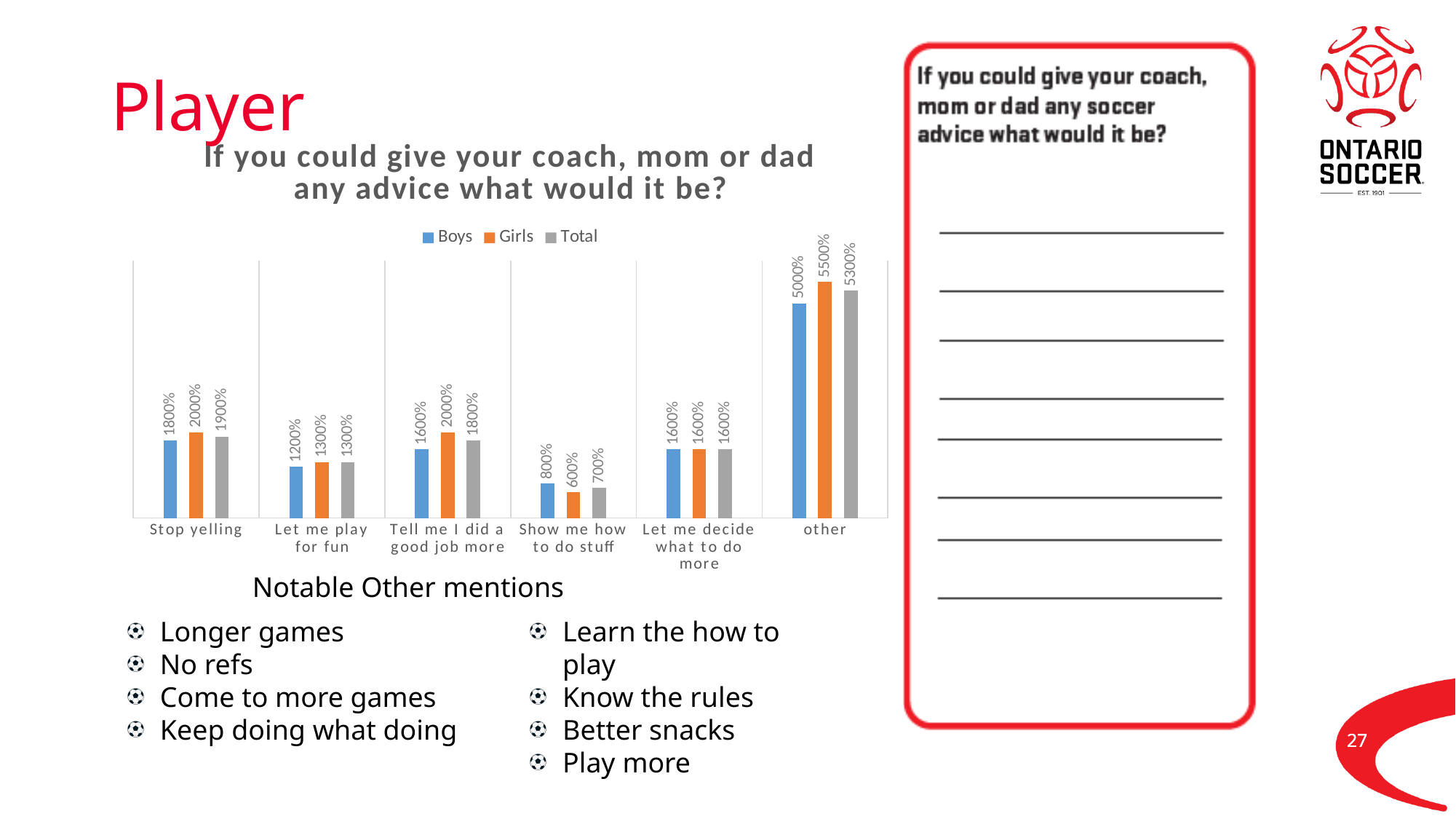
Which is larger for "Let me play for fun": the Boys value or the Girls value? Girls How many categories are shown on the x axis? 6 Which category has the lowest Boys value? Show me how to do stuff What is the Total value for "Show me how to do stuff"? 700% Which series is shown in orange in the legend? Girls Which category has the highest Total value? other What is the Girls value for "other"? 5500% What kind of chart is shown on the slide? Bar chart What is the Boys value for "Stop yelling"? 1800% What is the difference between the Girls and Boys values for "other"? 500% What is the Girls value for "Tell me I did a good job more"? 2000% How many series does the legend list? 3